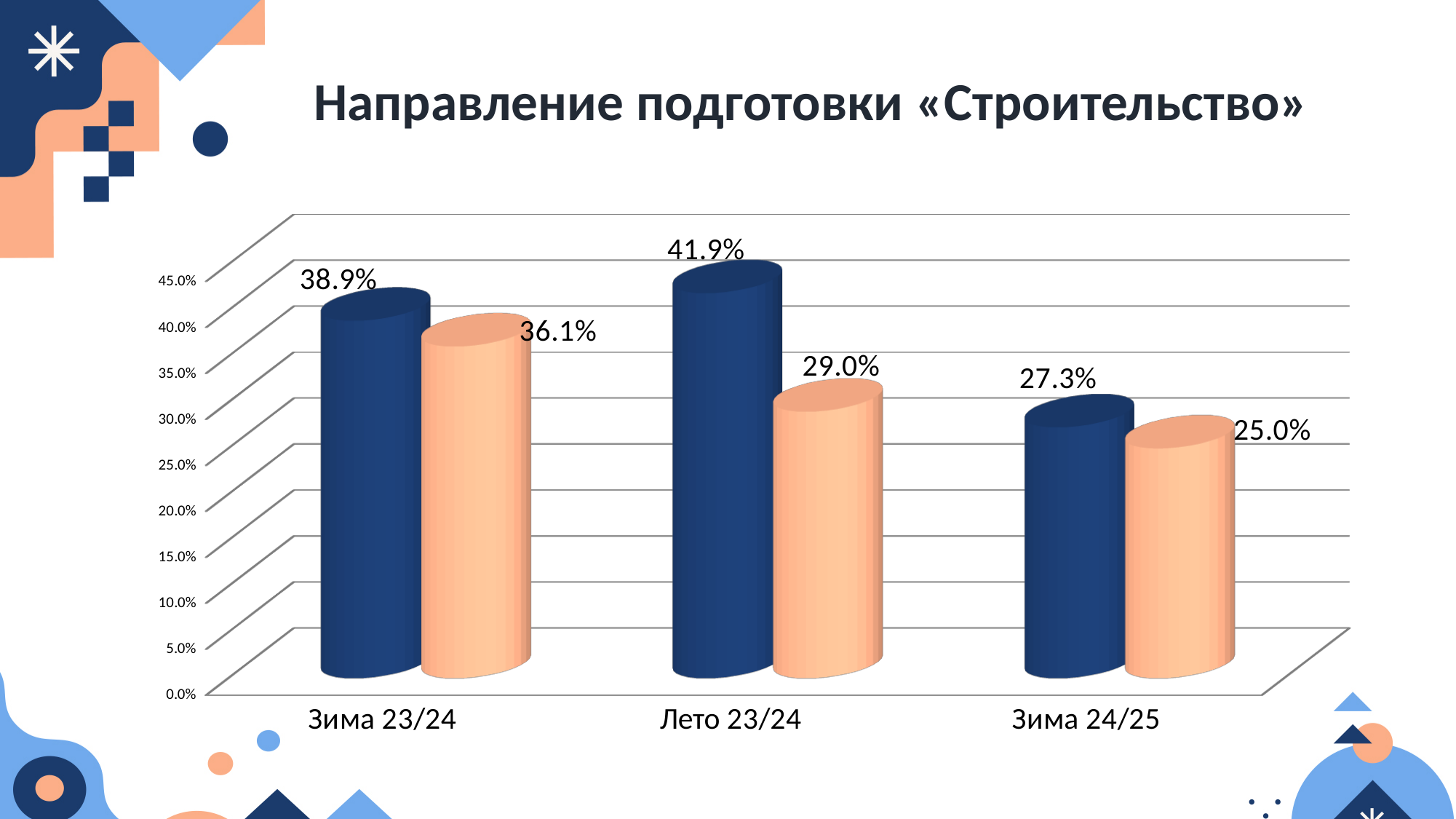
What is the difference between the dark blue and peach bars for Лето 23/24? 12.9% Which category has the highest dark blue bar? Лето 23/24 What is the value of the peach bar for Лето 23/24? 29.0% Which category has the lowest peach bar? Зима 24/25 What kind of chart is shown on the slide? bar chart How many bars are plotted for each category? 2 What is the value of the dark blue bar for Зима 24/25? 27.3% How many categories are shown on the x axis? 3 What is the title of the slide? Направление подготовки «Строительство» What is the value of the dark blue bar for Зима 23/24? 38.9% Which is larger for Зима 23/24: the dark blue bar or the peach bar? the dark blue bar What is the value of the peach bar for Зима 24/25? 25.0%